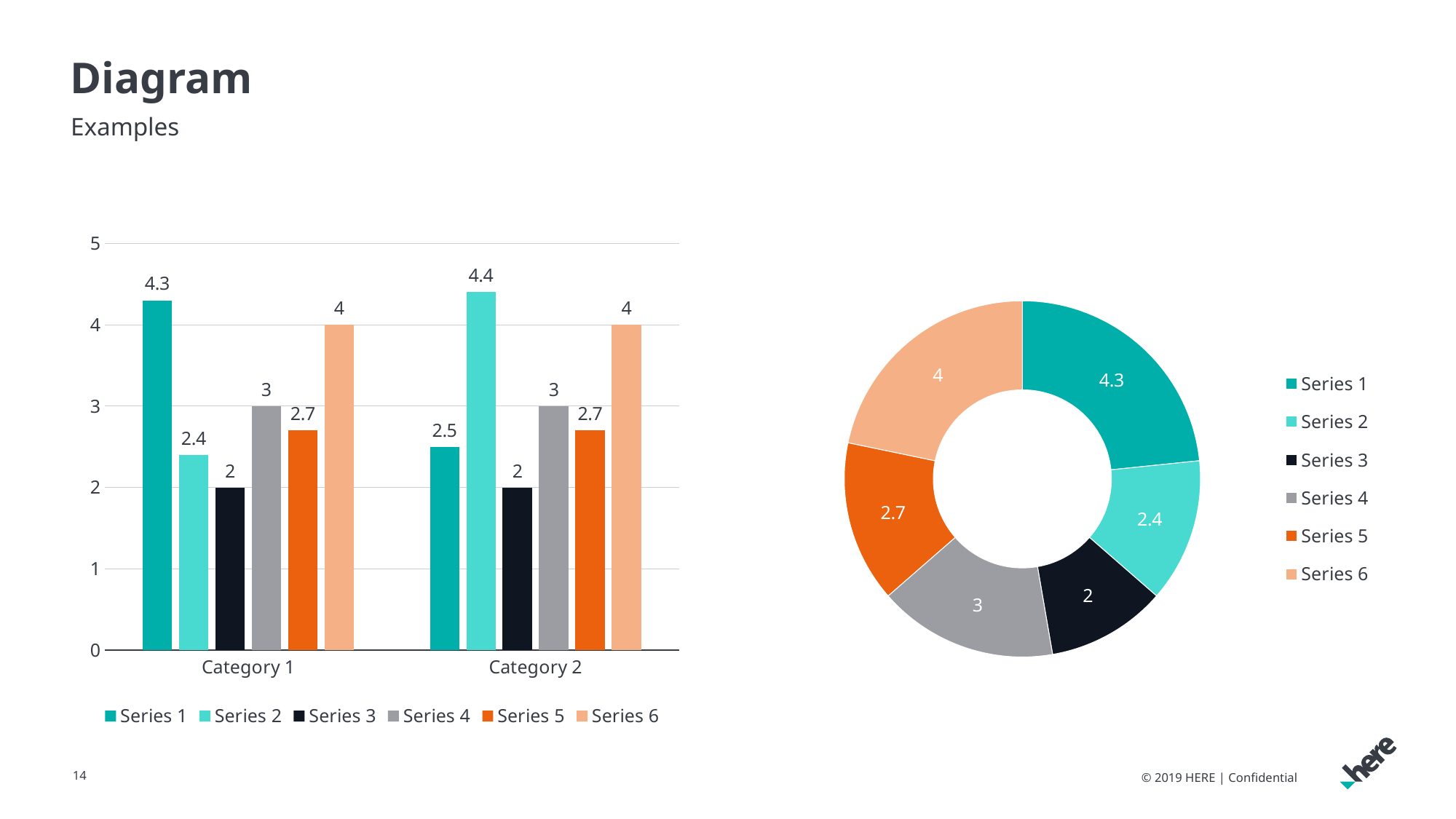
In the bar chart on the left, how many series does the legend list? 6 In the bar chart on the left, which series has the highest value in Category 2? Series 2 In the bar chart on the left, what is the value of Series 1 for Category 1? 4.3 In the bar chart on the left, how many categories are shown on the x axis? 2 In the bar chart on the left, which is larger: Series 5 or Series 6 in Category 1? Series 6 In the doughnut chart on the right, what is the difference between the Series 6 and Series 2 values? 1.6 In the bar chart on the left, which series has the lowest value in Category 1? Series 3 In the bar chart on the left, what is the value of Series 2 for Category 2? 4.4 In the doughnut chart on the right, which series has the largest slice? Series 1 In the bar chart on the left, what is the difference between Series 1 in Category 1 and Series 1 in Category 2? 1.8 What kind of chart is shown on the right side of the slide? Doughnut chart In the doughnut chart on the right, what is the value of Series 5? 2.7